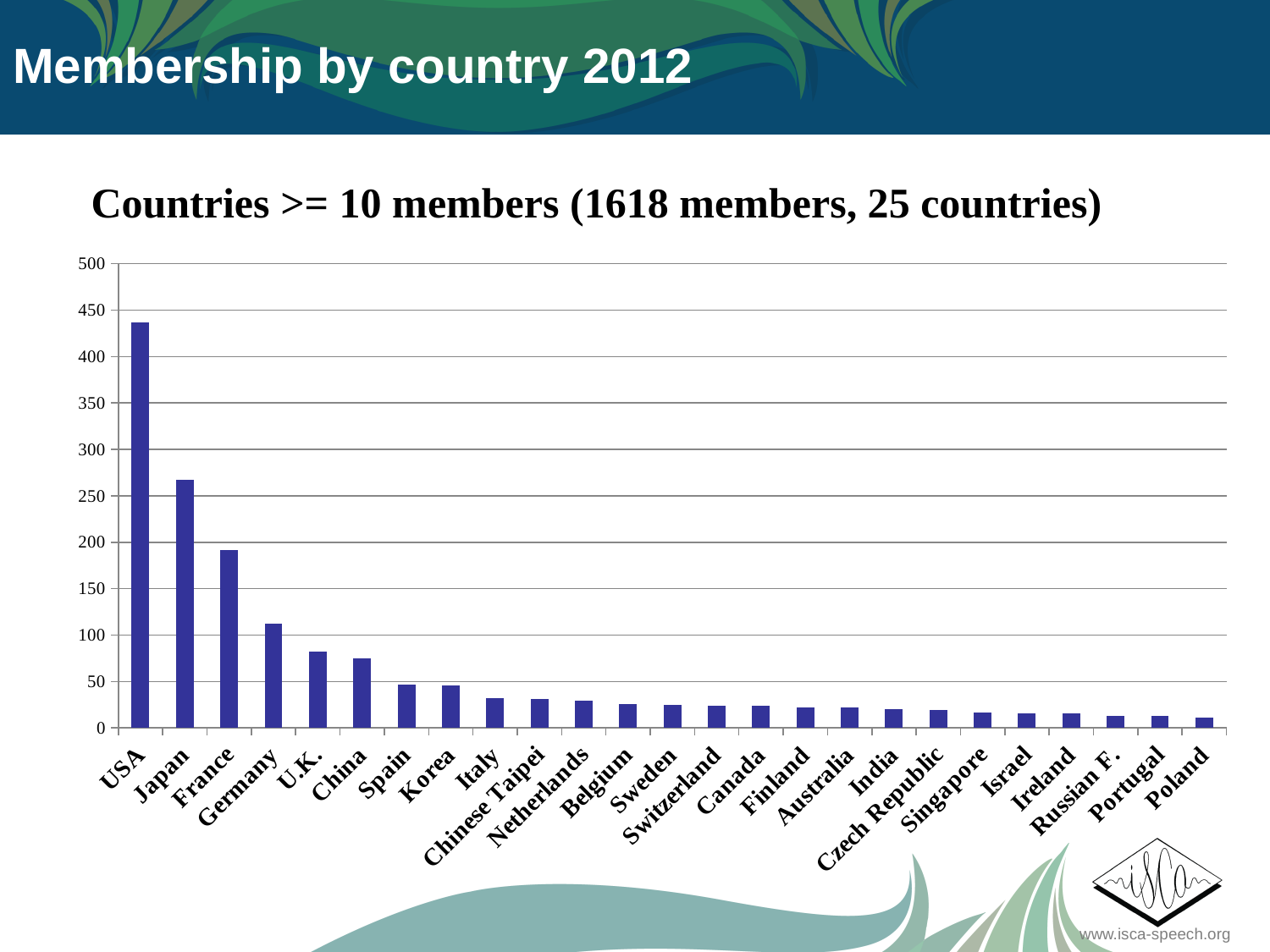
Is the value for U.K. greater or less than 100? less Is the value for France greater or less than 200? less Which has more members, Japan or France? Japan Do the values rise or fall moving from left to right along the x axis? fall Which country has the lowest membership in the chart? Poland Is the value for Germany greater or less than 100? greater What is the title shown above the chart? Countries >= 10 members (1618 members, 25 countries) Which country has the highest membership in the chart? USA How many countries are shown in the chart? 25 What kind of chart is shown on the slide? bar chart